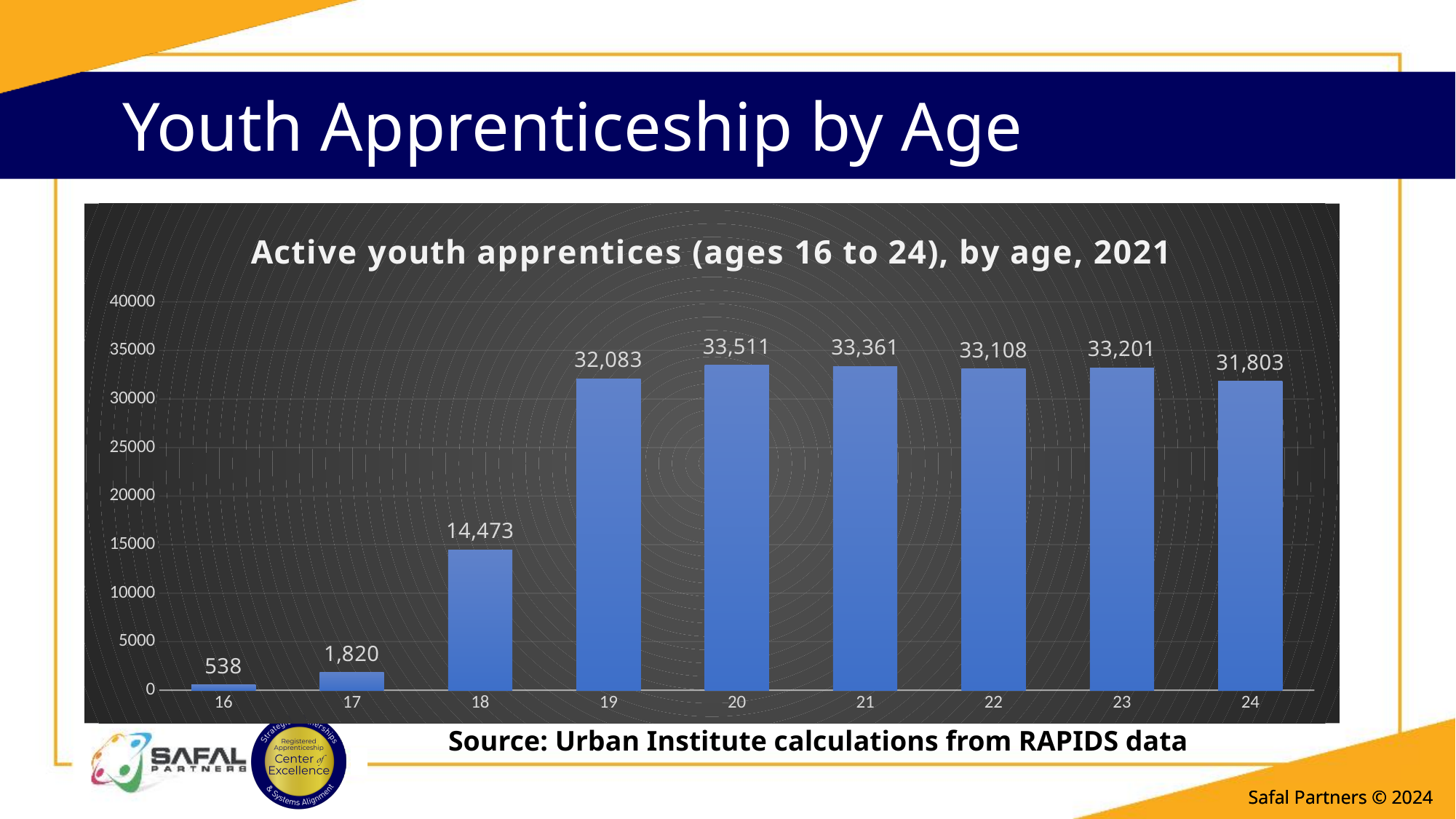
Which age has the highest number of active youth apprentices? 20 How many age categories are shown on the x axis? 9 What is the number of active youth apprentices aged 18? 14,473 What is the difference between the values for age 20 and age 19? 1,428 Is the value for age 18 greater or less than 15000? less Which is larger, the value for age 23 or the value for age 24? 23 What is the difference between the values for age 17 and age 16? 1,282 What is the title of the chart? Active youth apprentices (ages 16 to 24), by age, 2021 What kind of chart is shown on the slide? bar chart What is the number of active youth apprentices aged 16? 538 What is the value shown for age 22? 33,108 Which age has the lowest number of active youth apprentices? 16